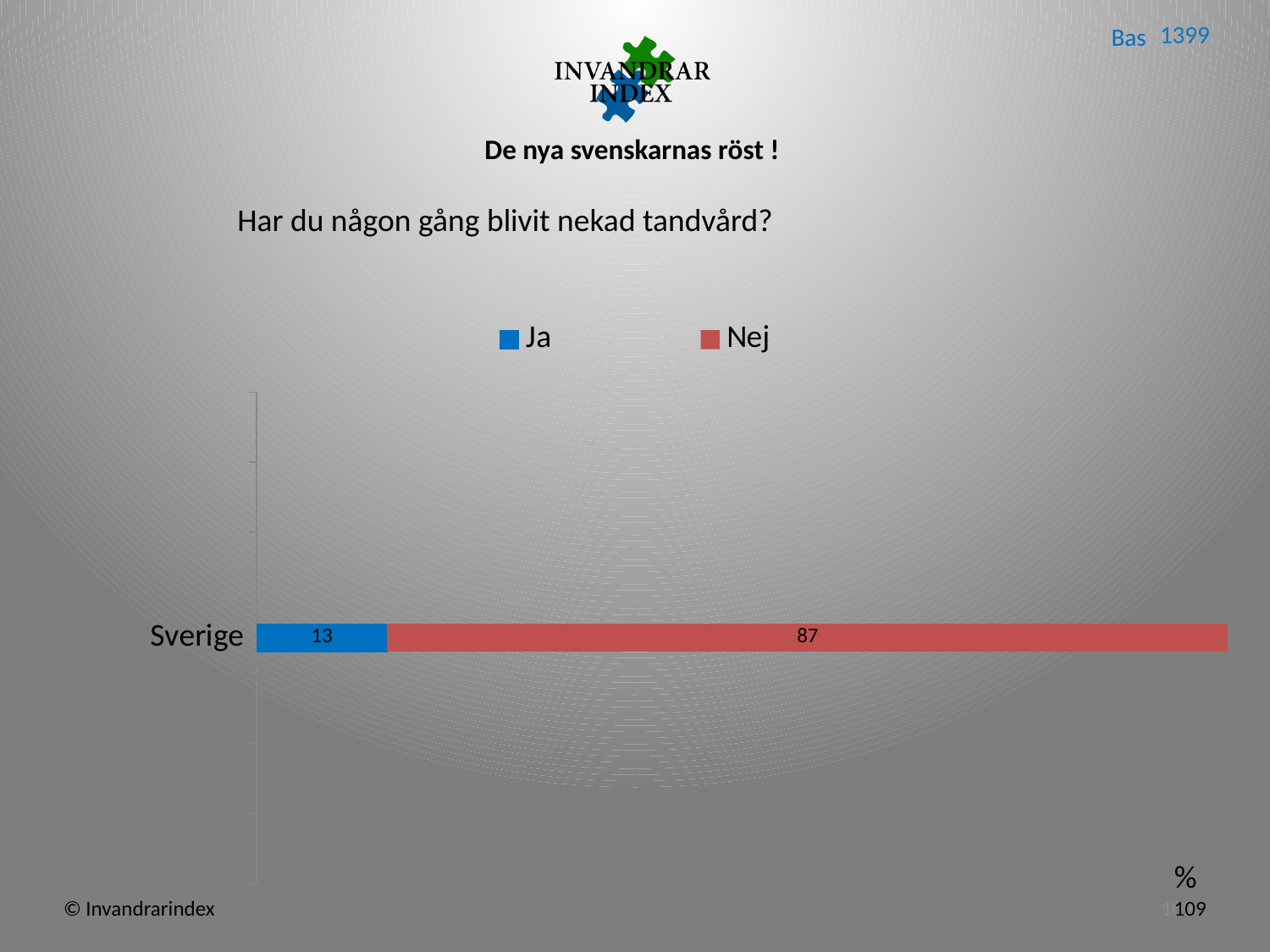
What is the difference between the Nej and Ja values for Sverige? 74 What kind of chart is shown on the slide? Stacked bar chart How many series does the legend list? 2 What is the value for Nej for Sverige? 87 How many categories are shown on the chart? 1 Which series has the larger value for Sverige, Ja or Nej? Nej What is the value for Ja for Sverige? 13 What is the total of the stacked bar for Sverige? 100 Which series has the smallest value for Sverige? Ja What is the name of the only category on the chart? Sverige Which colour represents the Ja series in the legend? Blue